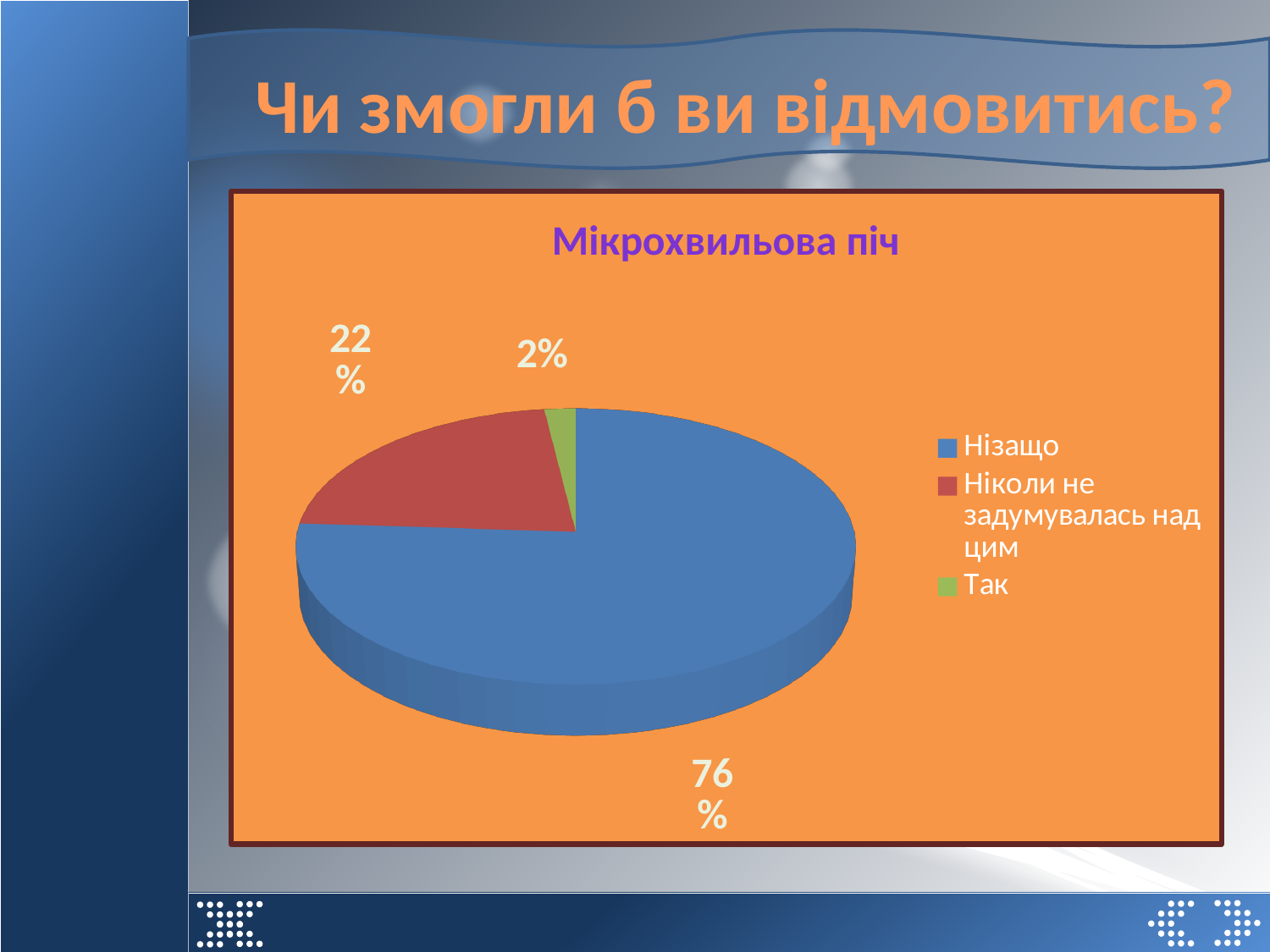
What share of the pie does the 'Так' slice represent? 2% What is the title of the chart? Мікрохвильова піч Which category has the smallest slice of the pie? Так What is the difference in percentage points between the 'Нізащо' and 'Ніколи не задумувалась над цим' slices? 54 Which category has the largest slice of the pie? Нізащо What share of the pie does the 'Нізащо' slice represent? 76% What share of the pie does the 'Ніколи не задумувалась над цим' slice represent? 22% What colour is the 'Так' slice in the pie chart? green How many slices does the pie chart have? 3 Which is larger, the 'Ніколи не задумувалась над цим' slice or the 'Так' slice? Ніколи не задумувалась над цим What kind of chart is shown on the slide? pie chart How many entries does the legend list? 3